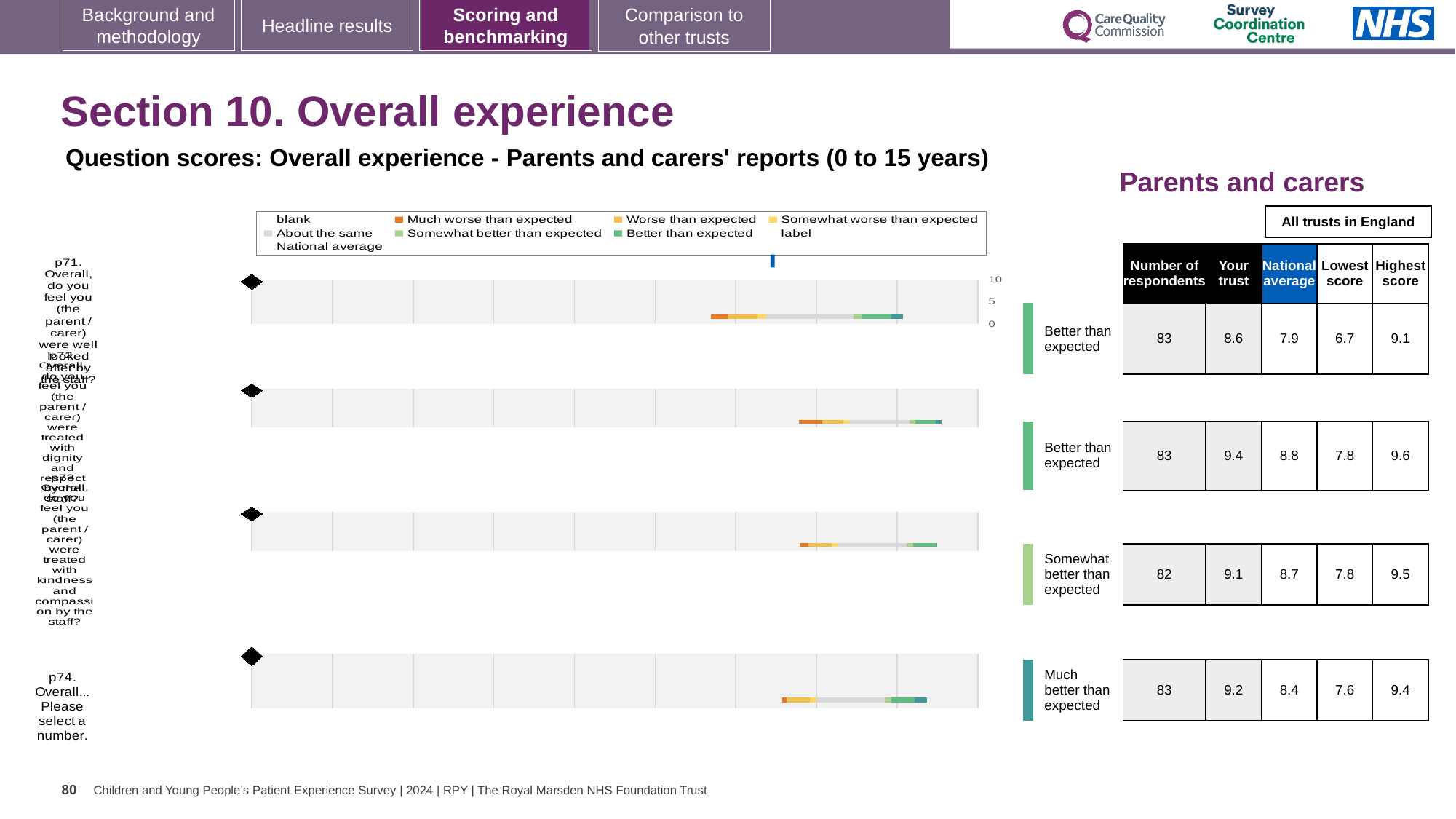
In the table beside the chart, what is the number of respondents for the third row from the top? 82 What kind of chart is shown on the slide? bar chart In the table beside the chart, what is the national average for the bottom row (p74)? 8.4 In the table beside the chart, what is the 'Your trust' score for the top row (p71)? 8.6 What is the title of the chart? Question scores: Overall experience - Parents and carers' reports (0 to 15 years) Which row has the lowest value in the 'Lowest score' column? the top row (p71), 6.7 For the bottom row (p74), which is larger: the 'Your trust' score or the national average? Your trust What is the difference between the 'Your trust' score and the national average for the top row (p71)? 0.7 What benchmark category is shown for the bottom row (p74)? Much better than expected In the table beside the chart, what is the highest score for the top row (p71)? 9.1 Which row has the highest 'Your trust' score in the table beside the chart? the second row from the top (9.4) How many question rows (bars) does the chart show? 4